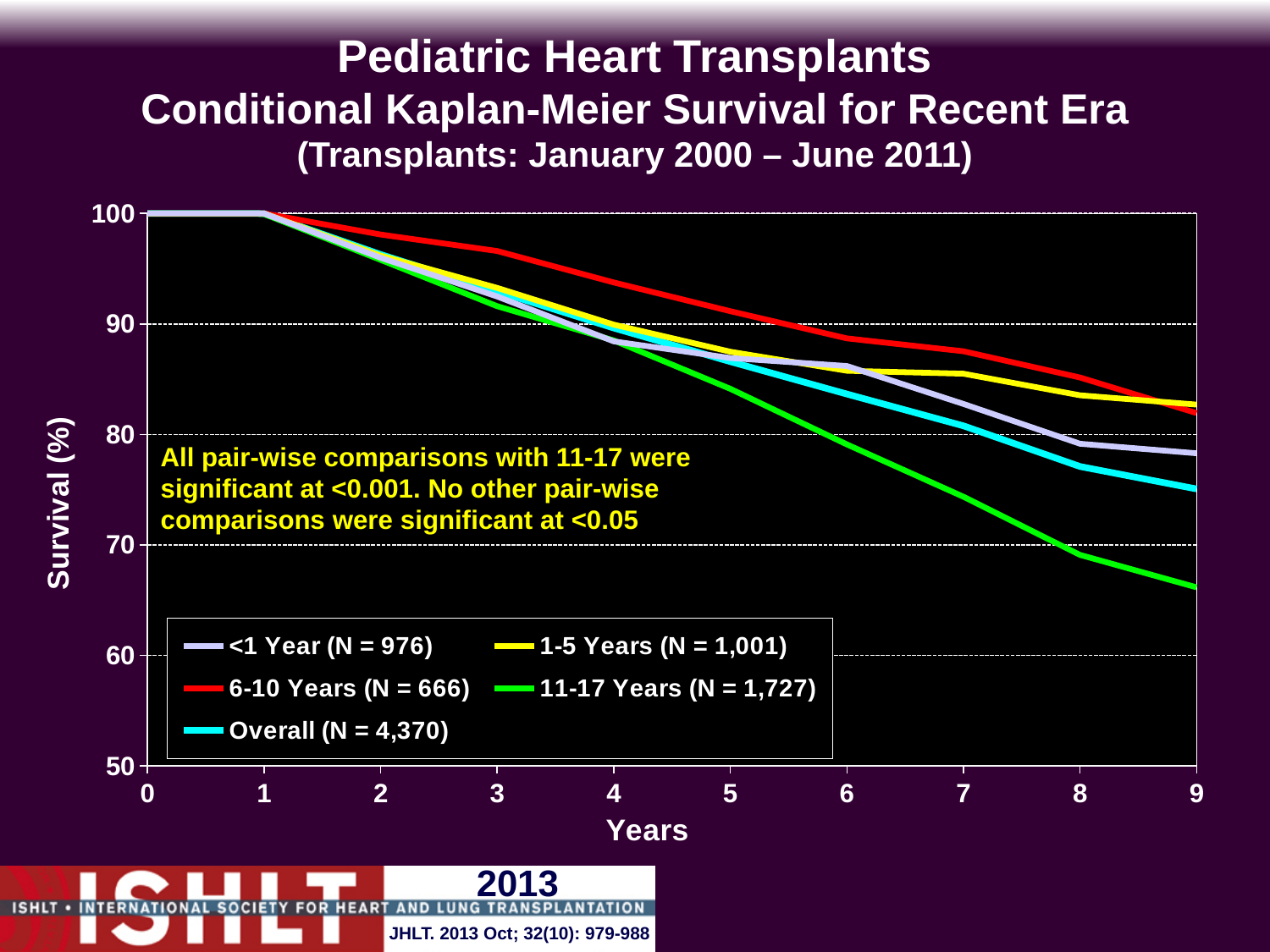
What is the N shown in the legend for the Overall group? 4,370 Is the survival value for the 6-10 Years group at year 9 greater or less than 80? greater Which group has the highest survival at year 5? 6-10 Years Is the survival value for the Overall group at year 9 greater or less than 80? less How many series does the legend list? 5 What kind of chart is shown on the slide? line chart What is the label of the y axis? Survival (%) At year 9, which is larger: the survival for Overall or for 11-17 Years? Overall Do the survival values rise or fall as years increase? fall Which group has the lowest survival at year 9? 11-17 Years Is the survival value for the 11-17 Years group at year 9 greater or less than 70? less What is the survival value for the <1 Year group at year 0? 100